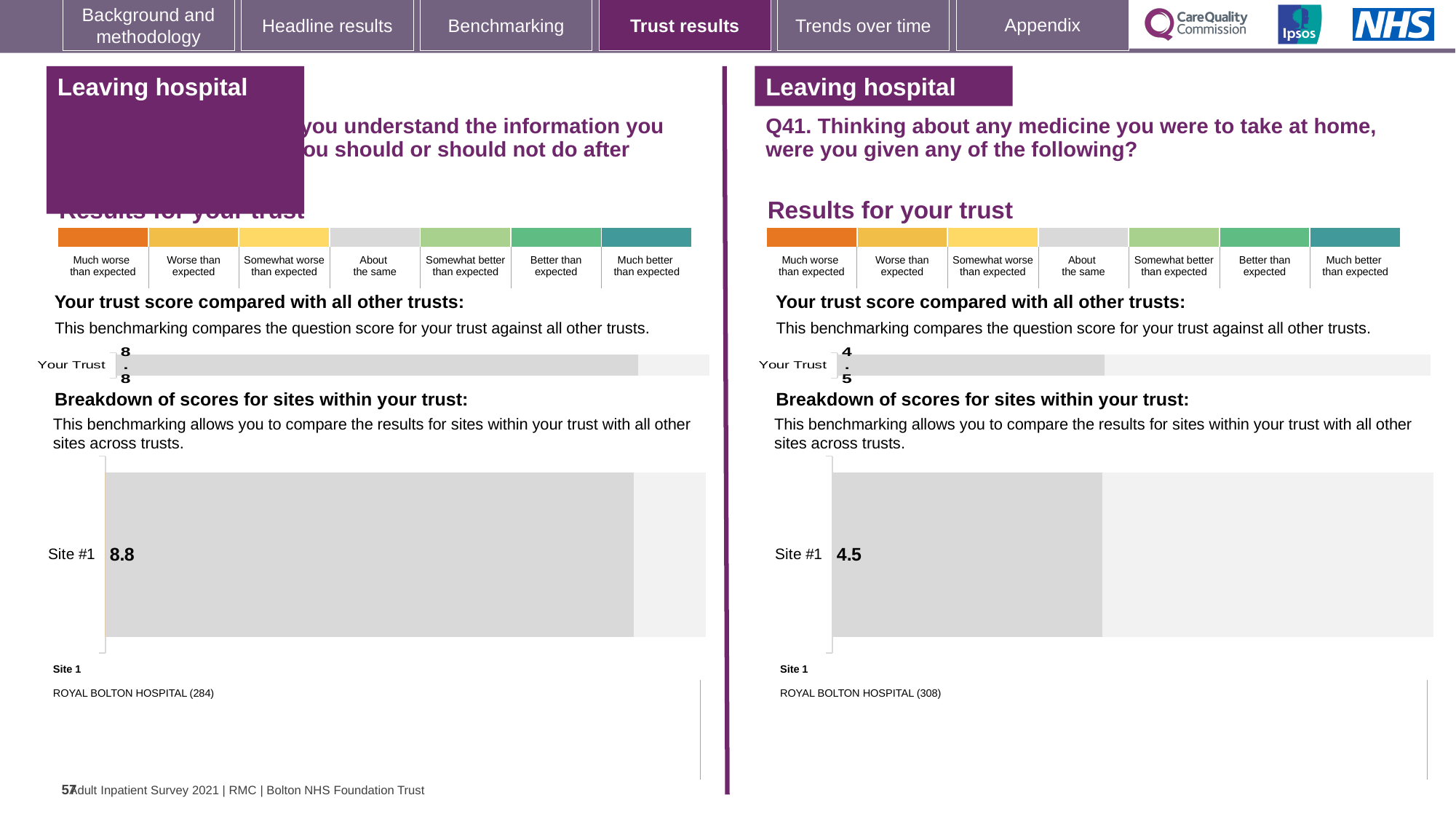
On the left panel's 'Breakdown of scores for sites within your trust' chart, what is the value for Site #1? 8.8 On the right panel (Q41) site breakdown chart, which hospital is listed as Site 1? ROYAL BOLTON HOSPITAL (308) What kind of chart is used for 'Your trust score compared with all other trusts' on the left panel? Bar chart On the right panel (Q41) 'Breakdown of scores for sites within your trust' chart, what is the value for Site #1? 4.5 On the right panel (Q41) 'Your trust score compared with all other trusts' chart, what is the value for Your Trust? 4.5 On the left panel's 'Your trust score compared with all other trusts' chart, what is the value for Your Trust? 8.8 What kind of chart is used for the 'Breakdown of scores for sites within your trust' on the right panel (Q41)? Bar chart How many sites are shown on the right panel's (Q41) 'Breakdown of scores for sites within your trust' chart? 1 Which is larger: the Site #1 value on the left panel's site breakdown chart or the Site #1 value on the right panel's (Q41) site breakdown chart? Left panel (8.8) On the left panel site breakdown chart, which hospital is listed as Site 1? ROYAL BOLTON HOSPITAL (284) How many sites are shown on the left panel's 'Breakdown of scores for sites within your trust' chart? 1 What is the difference between the Site #1 value on the left panel's site breakdown chart and the Site #1 value on the right panel's (Q41) site breakdown chart? 4.3